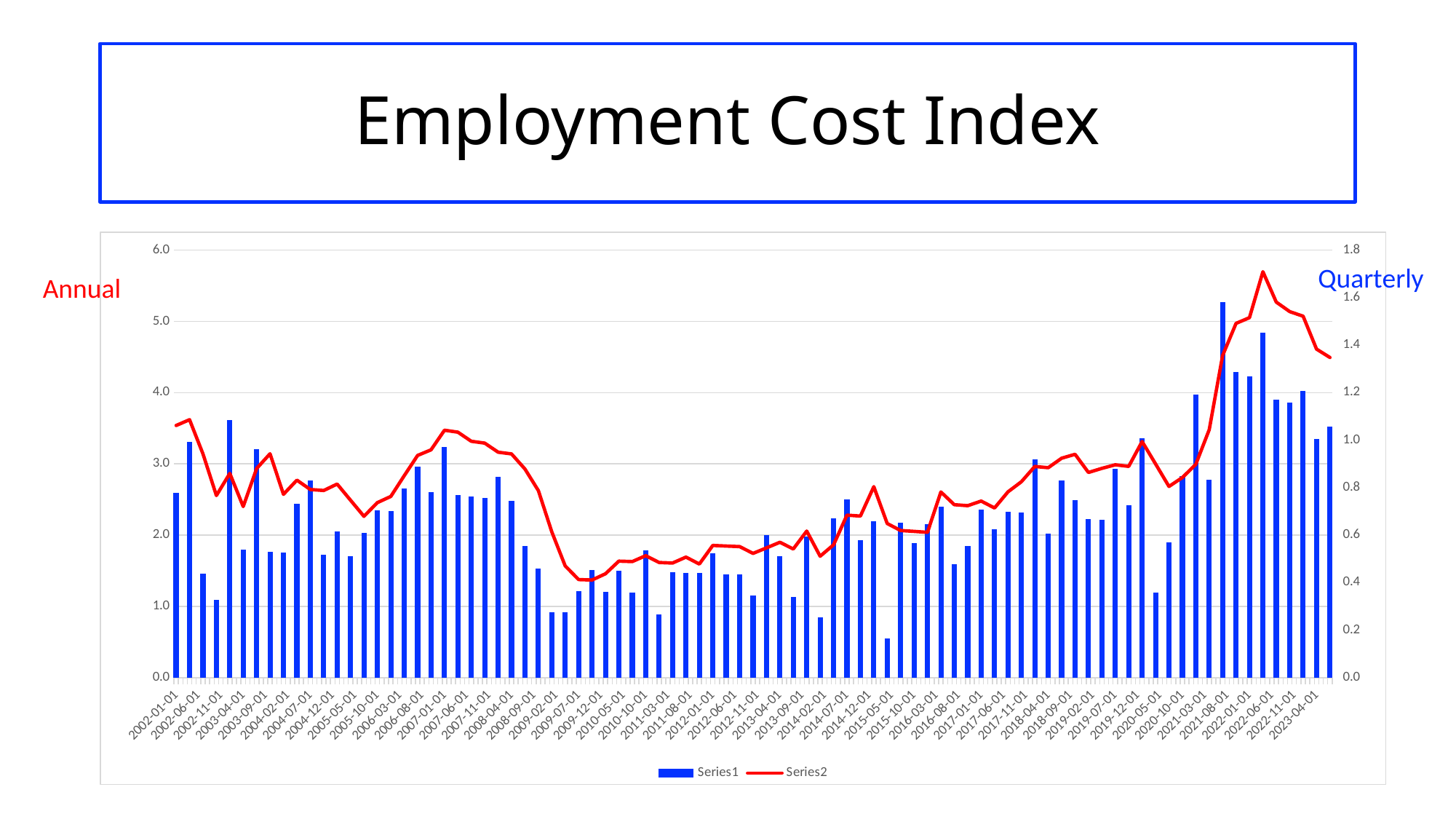
On the left-hand (Annual) axis, is the red line value at 2022-06-01 greater or less than 5.0? greater On the left-hand (Annual) axis, is the red line value at 2009-07-01 greater or less than 2.0? less Which is taller, the bar for 2021-08-01 or the bar for 2002-01-01? 2021-08-01 Which series is drawn as a red line? Series2 On the right-hand (Quarterly) axis, is the bar for 2009-02-01 greater or less than 0.4? less What is the title of the chart? Employment Cost Index What kind of chart is shown on the slide? A combined bar and line chart How many series does the legend list? 2 Does the red line rise or fall between 2020-10-01 and 2022-06-01? rise Does the red line rise or fall between 2008-09-01 and 2009-07-01? fall